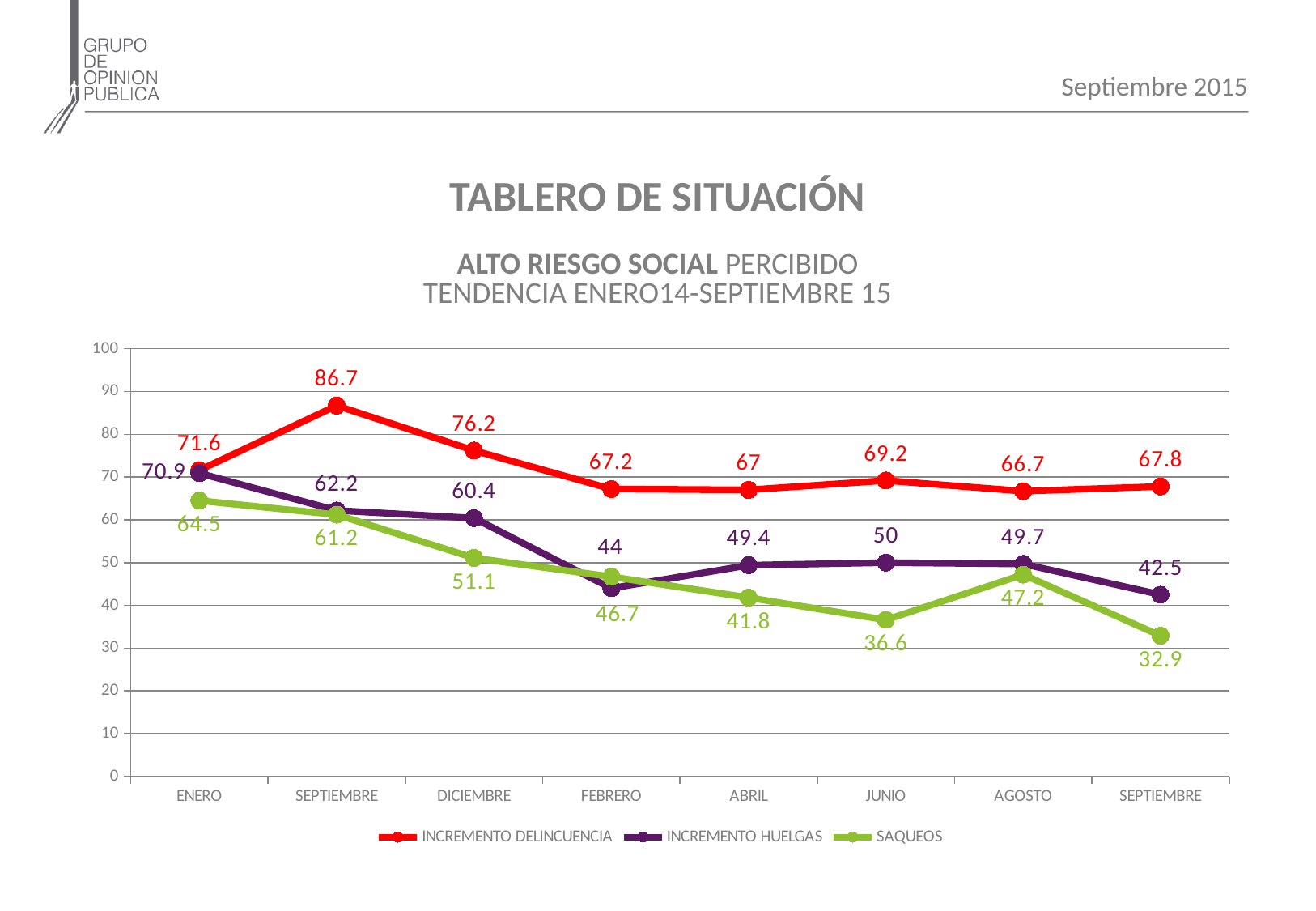
What is the value of INCREMENTO HUELGAS at FEBRERO? 44 At ABRIL, what is the difference between INCREMENTO DELINCUENCIA and INCREMENTO HUELGAS? 17.6 How many points are plotted along the x axis for each series? 8 What kind of chart is shown on the slide? Line chart At AGOSTO, which is larger: INCREMENTO HUELGAS or SAQUEOS? INCREMENTO HUELGAS What is the highest value reached by the INCREMENTO DELINCUENCIA series? 86.7 By how much did SAQUEOS decrease from ENERO (64.5) to the final SEPTIEMBRE point (32.9)? 31.6 Does the SAQUEOS series rise or fall from ENERO to FEBRERO? Fall What is the value of SAQUEOS at JUNIO? 36.6 How many series does the legend list? 3 What is the value of INCREMENTO DELINCUENCIA at DICIEMBRE? 76.2 What is the lowest value reached by the SAQUEOS series? 32.9